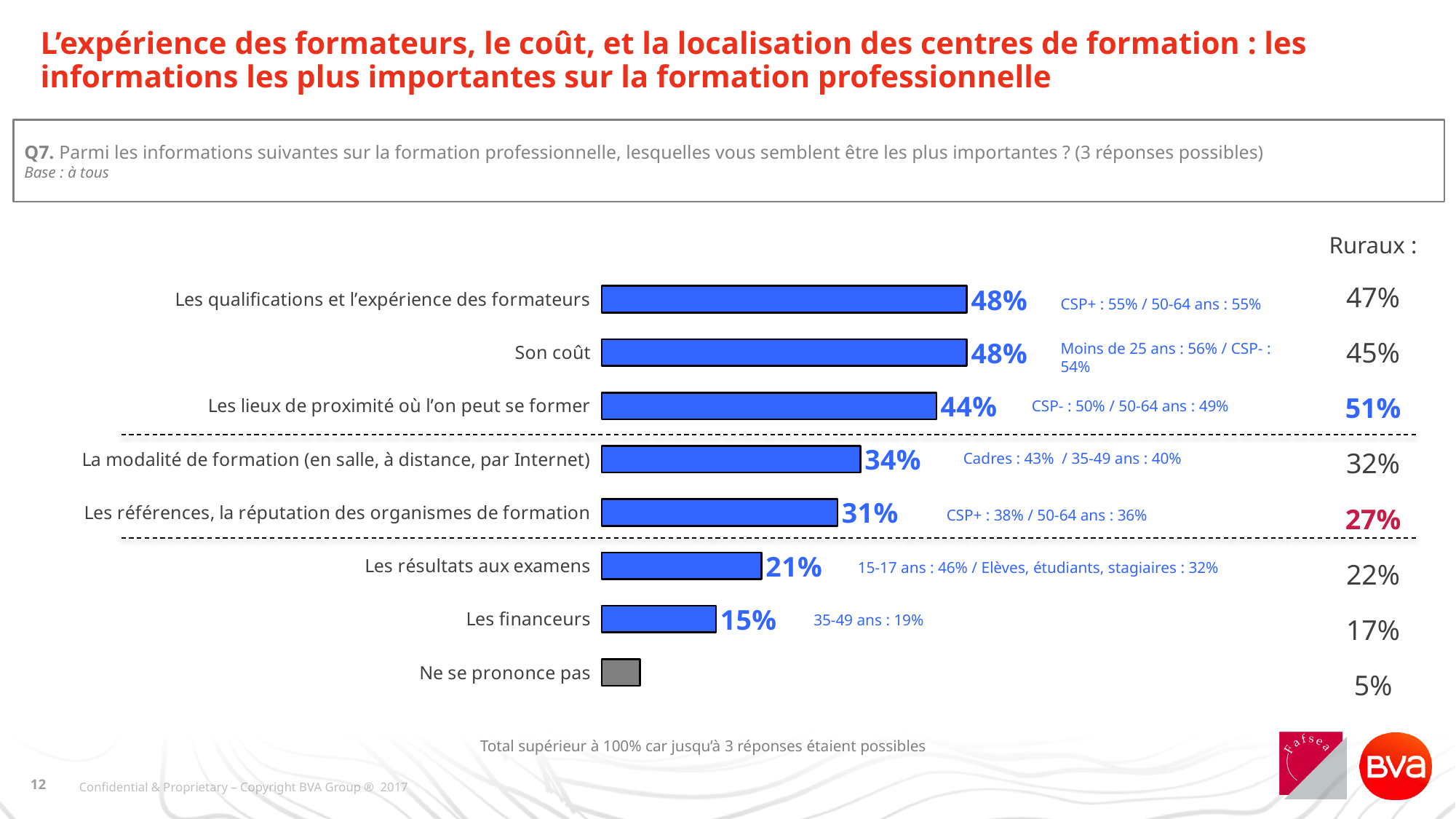
What colour is the bar for "Ne se prononce pas"? Gray What is the value for "Les lieux de proximité où l'on peut se former"? 44% How many categories are shown in the chart? 8 What is the value for "Les financeurs"? 15% What is the difference between the values for "Les résultats aux examens" and "Les financeurs"? 6 percentage points What is the Ruraux value shown for "Les lieux de proximité où l'on peut se former"? 51% What is the Ruraux value shown for "Ne se prononce pas"? 5% What is the difference between the values for "Son coût" and "Les lieux de proximité où l'on peut se former"? 4 percentage points What is the value for "La modalité de formation (en salle, à distance, par Internet)"? 34% Which is larger: the value for "Les références, la réputation des organismes de formation" or for "Les résultats aux examens"? Les références, la réputation des organismes de formation What kind of chart is shown on the slide? Bar chart Which category has the shortest bar? Ne se prononce pas